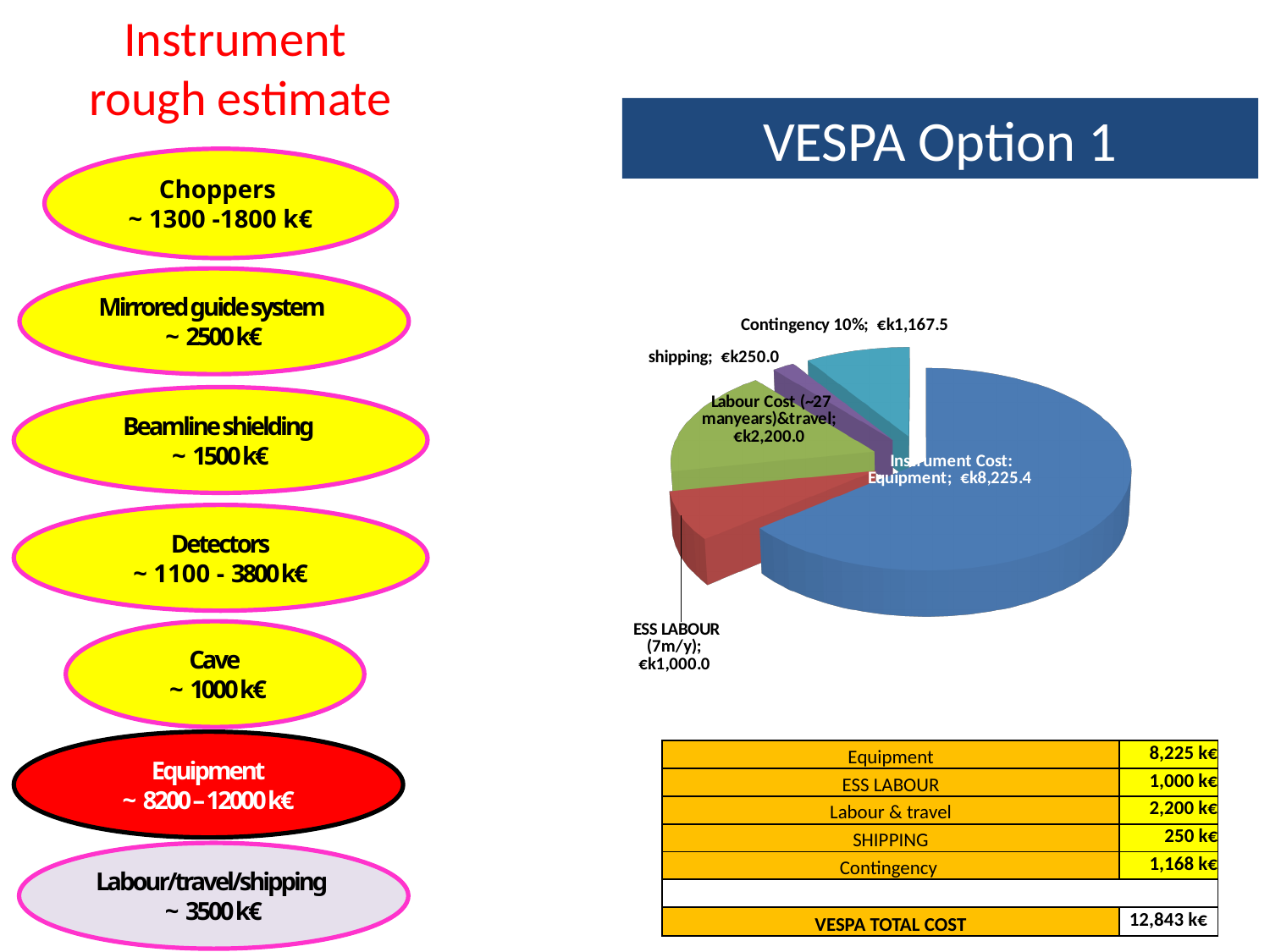
What is the value shown for the shipping slice of the pie chart? €k250.0 How many slices does the pie chart have? 5 What kind of chart is shown on the VESPA Option 1 slide? pie chart Which slice of the pie chart has the smallest value? shipping Which slice of the pie chart has the largest value? Instrument Cost: Equipment In the pie chart, how much larger is the Instrument Cost: Equipment value than the Labour Cost (~27 manyears)&travel value? €k6,025.4 In the pie chart, which is larger: the Contingency 10% slice or the ESS LABOUR (7m/y) slice? Contingency 10% What is the value shown for the Labour Cost (~27 manyears)&travel slice of the pie chart? €k2,200.0 What is the value shown for the Instrument Cost: Equipment slice of the pie chart? €k8,225.4 What is the value shown for the ESS LABOUR (7m/y) slice of the pie chart? €k1,000.0 What is the value shown for the Contingency 10% slice of the pie chart? €k1,167.5